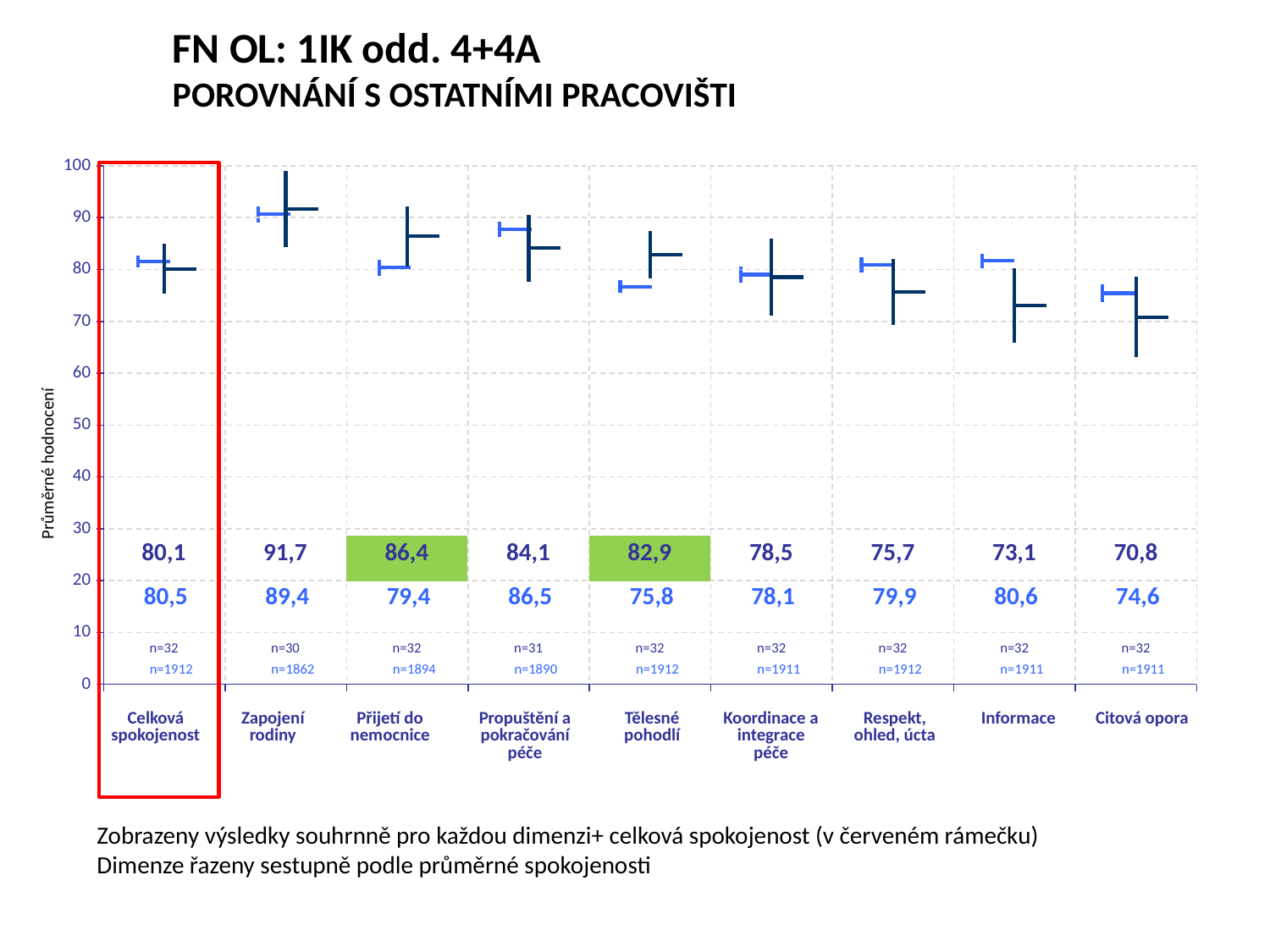
How many dimensions (categories) are shown along the x axis? 9 What is the top value shown for Celková spokojenost? 80,1 Which dimension has the lowest top (dark blue) value? Citová opora Which dimension has the highest top (dark blue) value? Zapojení rodiny What is the lower (light blue) value shown for Informace? 80,6 Is the top value for Koordinace a integrace péče greater or less than 80? less What is the lower value shown for Tělesné pohodlí? 75,8 What is the difference between the top and lower values for Přijetí do nemocnice? 7,0 For Propuštění a pokračování péče, which is larger: the top value or the lower value? the lower value (86,5) Which category is highlighted with a red frame? Celková spokojenost What is the top (dark blue) value shown for Zapojení rodiny? 91,7 What is the n value printed in the first row under Zapojení rodiny? n=30